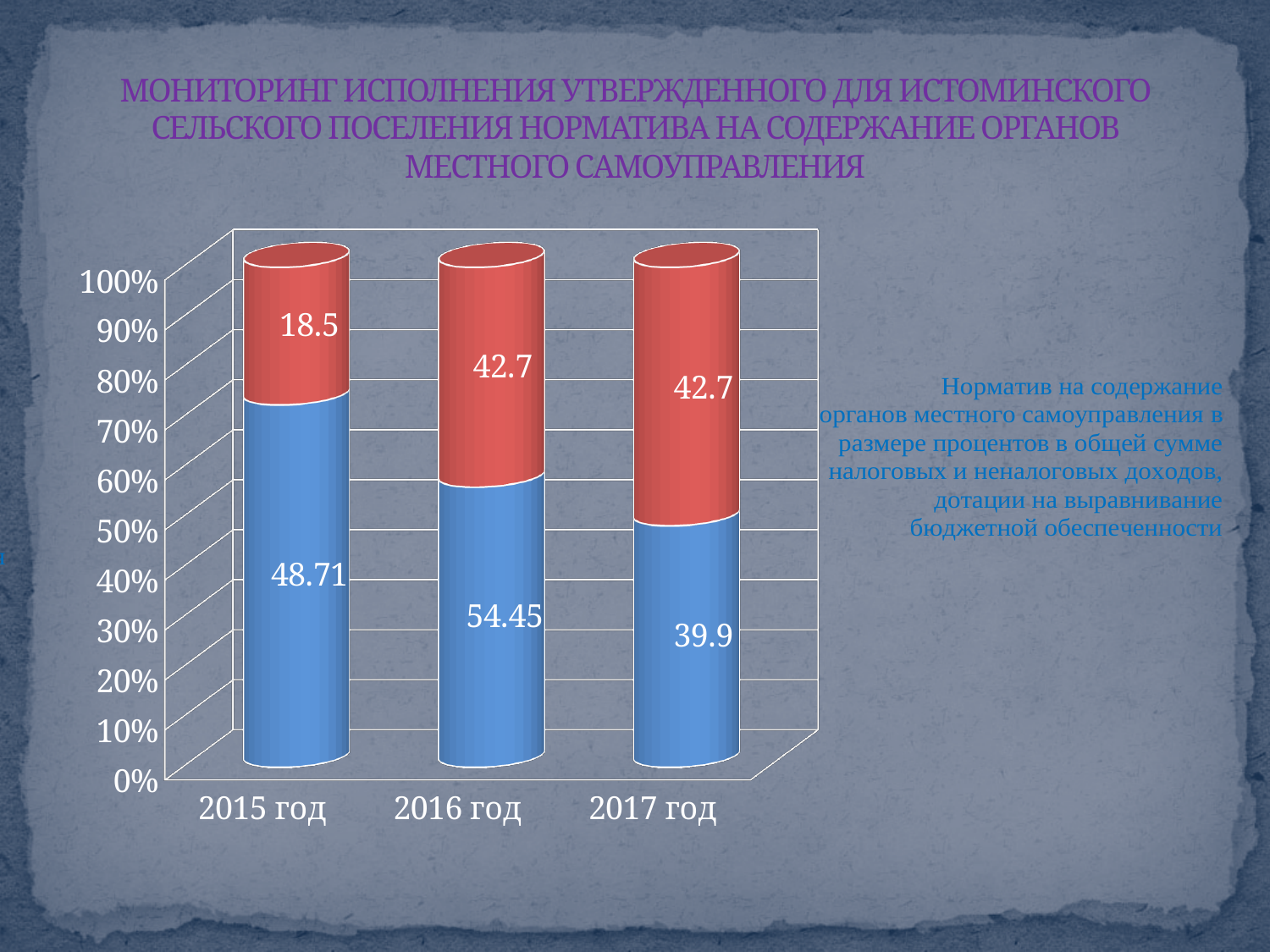
Do the red segment values rise or fall from 2015 год to 2016 год? Rise What value is shown on the red segment of the bar for 2015 год? 18.5 What kind of chart is shown on the slide? Stacked bar chart What is the difference between the red segment values for 2016 год and 2015 год? 24.2 What value is shown on the blue segment of the bar for 2017 год? 39.9 What is the difference between the blue segment values for 2016 год and 2017 год? 14.55 What value is shown on the red segment of the bar for 2016 год? 42.7 How many years are shown on the x axis of the chart? 3 Which year has the lowest value on its red segment? 2015 год Which year has the highest value on its blue segment? 2016 год What value is shown on the blue segment of the bar for 2015 год? 48.71 Which is larger: the blue segment value for 2015 год or for 2017 год? 2015 год